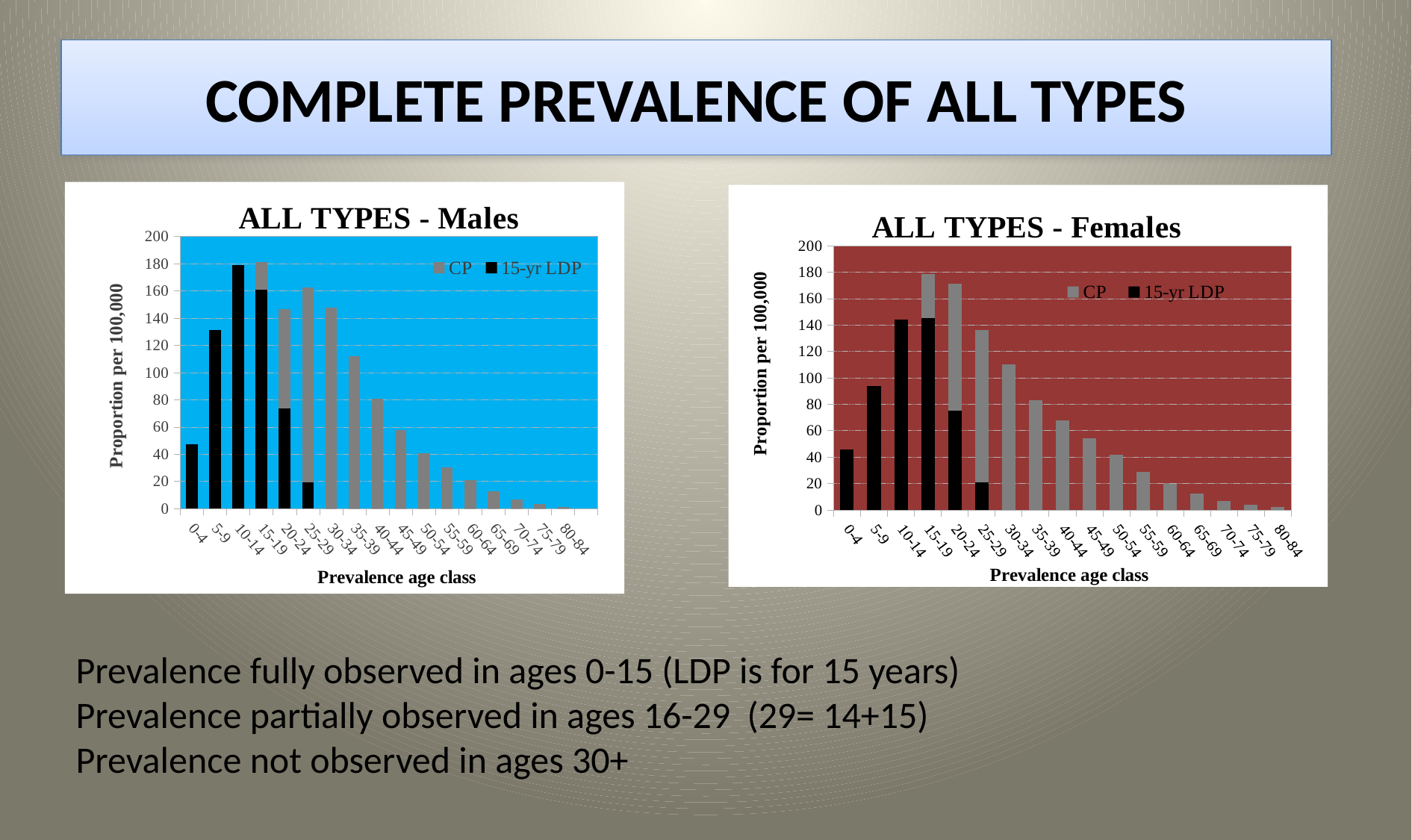
In the 'ALL TYPES - Males' chart, which age class has the highest 15-yr LDP value? 10-14 In the 'ALL TYPES - Females' chart, is the CP value for 45-49 greater or less than 60? less In the 'ALL TYPES - Females' chart, is the 15-yr LDP value for 5-9 greater or less than 80? greater What colour are the 15-yr LDP bars in the 'ALL TYPES - Females' chart? black How many age classes are shown on the x axis of the 'ALL TYPES - Males' chart? 17 What kind of chart is the 'ALL TYPES - Males' chart? bar chart In the 'ALL TYPES - Females' chart, do the CP values rise or fall from age class 30-34 to 80-84? fall In the 'ALL TYPES - Females' chart, which age class has the highest CP value? 25-29 What is the y-axis label of the 'ALL TYPES - Males' chart? Proportion per 100,000 In the 'ALL TYPES - Males' chart, is the CP value for 35-39 greater or less than 100? greater How many series does the legend of the 'ALL TYPES - Females' chart list? 2 In the 'ALL TYPES - Males' chart, which is larger, the CP value for 30-34 or for 40-44? 30-34